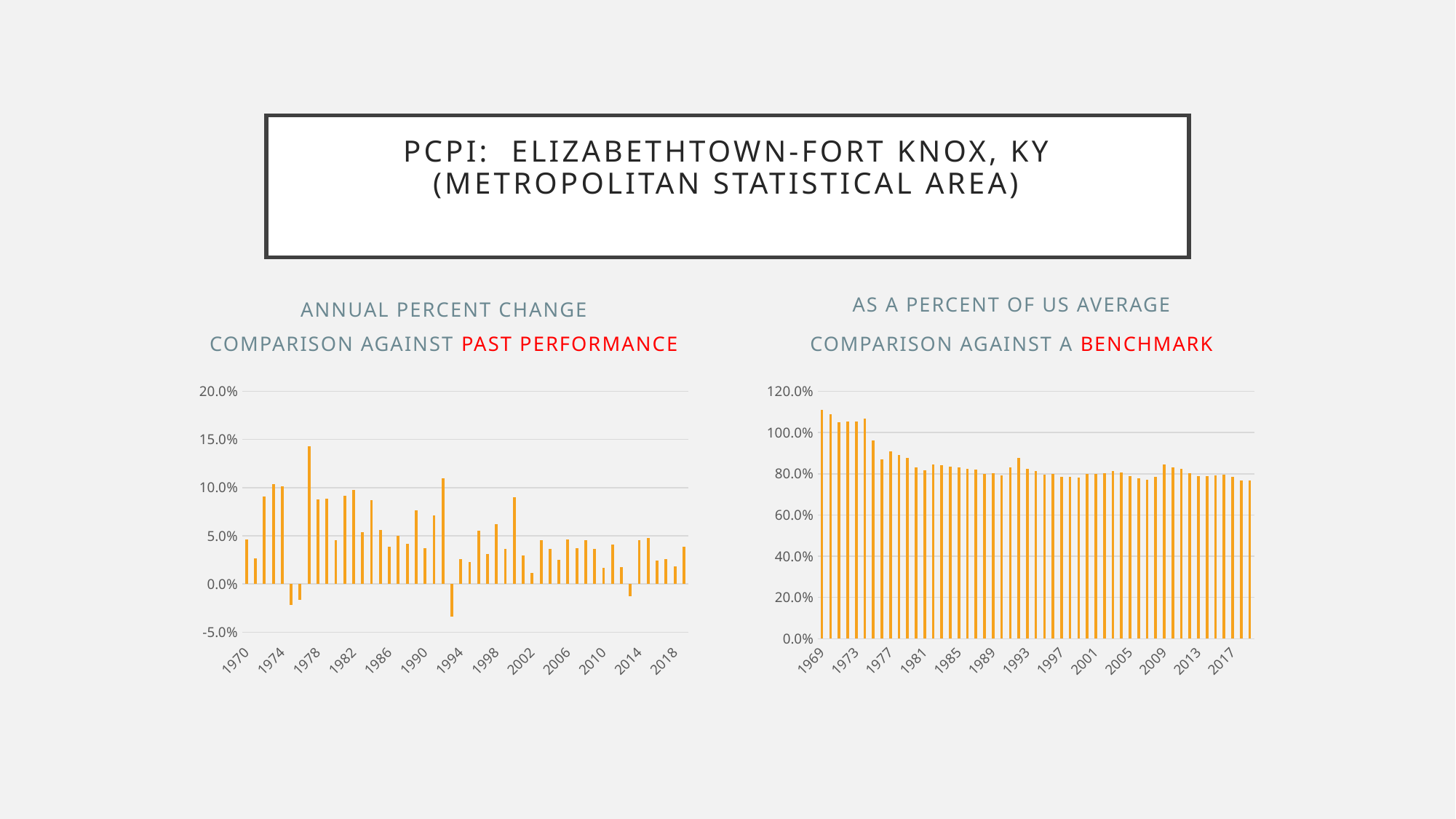
In the 'As a Percent of US Average' chart on the right, which year has the highest value? 1969 In the 'Annual Percent Change' chart on the left, is the value for 1993 greater or less than 0.0%? less In the 'As a Percent of US Average' chart on the right, is the value for 2017 greater or less than 100.0%? less What kind of chart is the 'Annual Percent Change' chart on the left? bar chart In the 'As a Percent of US Average' chart on the right, which is larger, the value for 1973 or the value for 2001? 1973 In the 'As a Percent of US Average' chart on the right, is the value for 1969 greater or less than 100.0%? greater What kind of chart is the 'As a Percent of US Average' chart on the right? bar chart What is the title of the chart on the right? As a Percent of US Average In the 'Annual Percent Change' chart on the left, which year has the highest value? 1977 In the 'Annual Percent Change' chart on the left, which year has the lowest value? 1993 In the 'As a Percent of US Average' chart on the right, do the values generally rise or fall from 1969 to 2017? fall